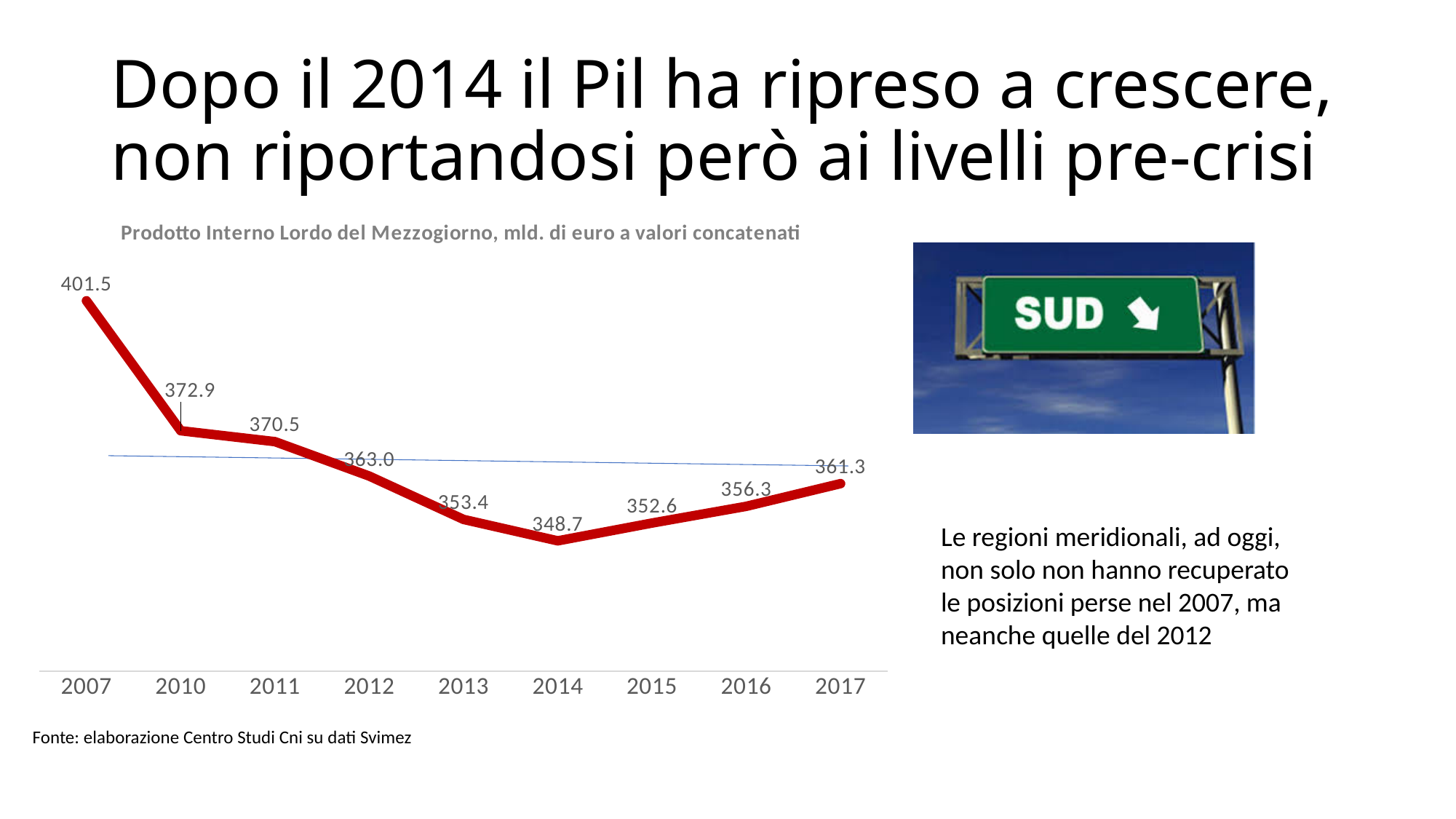
Which year has the lowest value? 2014 What is the value for 2017? 361.3 What is the value for 2012? 363.0 What is the difference between the values for 2017 and 2014? 12.6 How many years are plotted on the x axis? 9 Which year has the highest value? 2007 What is the value for 2007? 401.5 What kind of chart is this? line chart Which is larger, the value for 2012 or the value for 2017? 2012 What is the difference between the values for 2007 and 2017? 40.2 Do the values rise or fall from 2014 to 2017? rise What is the value for 2014? 348.7